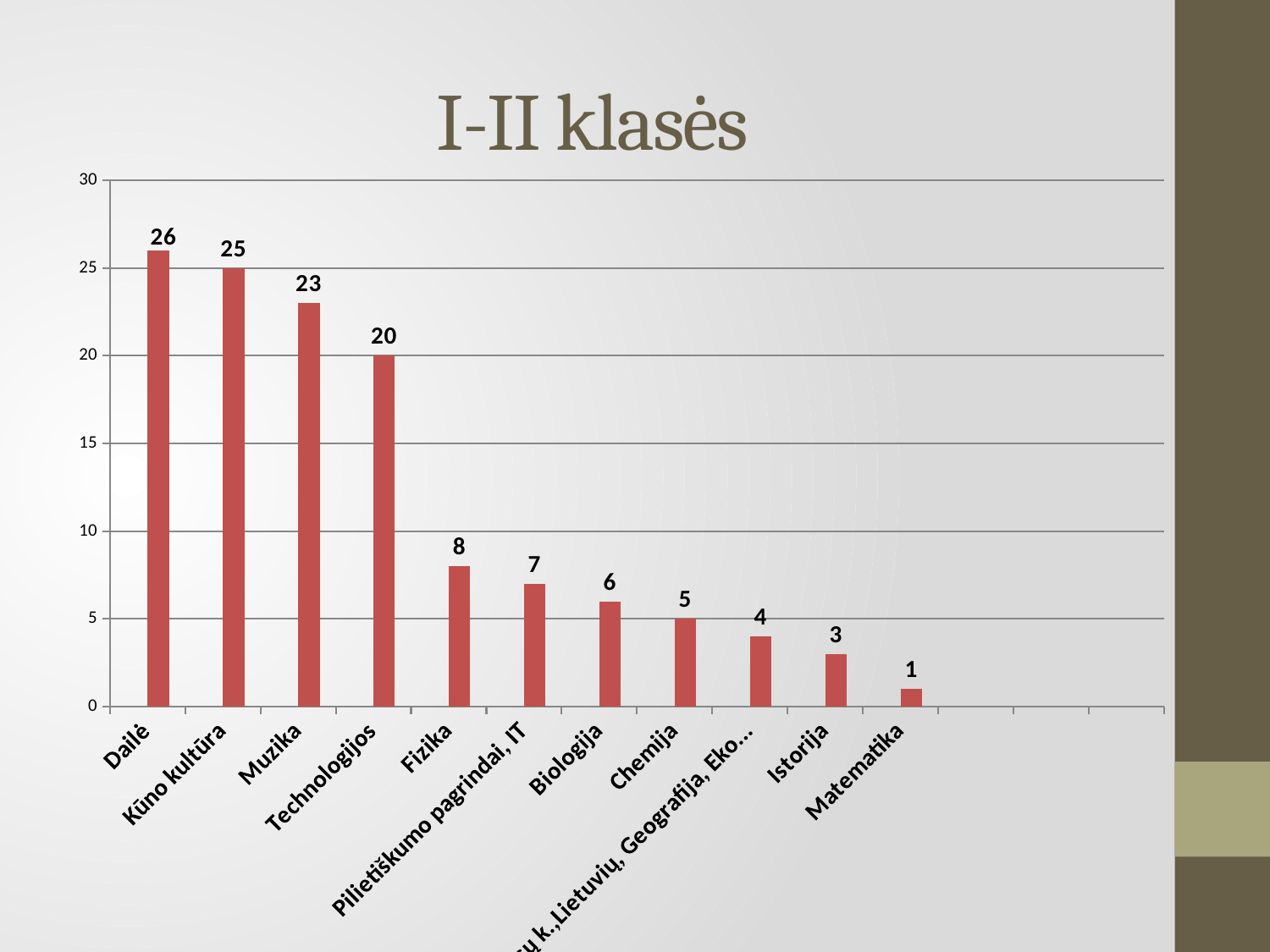
Is the value for Muzika greater or less than 20? greater Which category has the highest value? Dailė What kind of chart is shown on the slide? Bar chart How many categories are shown on the x axis? 11 What is the difference between the values for Fizika and Istorija? 5 What is the value for Biologija? 6 What is the value for Dailė? 26 What is the value for Technologijos? 20 Which category has the lowest value? Matematika What is the difference between the values for Kūno kultūra and Muzika? 2 Which is larger, the value for Chemija or the value for Istorija? Chemija What is the title of the chart? I-II klasės